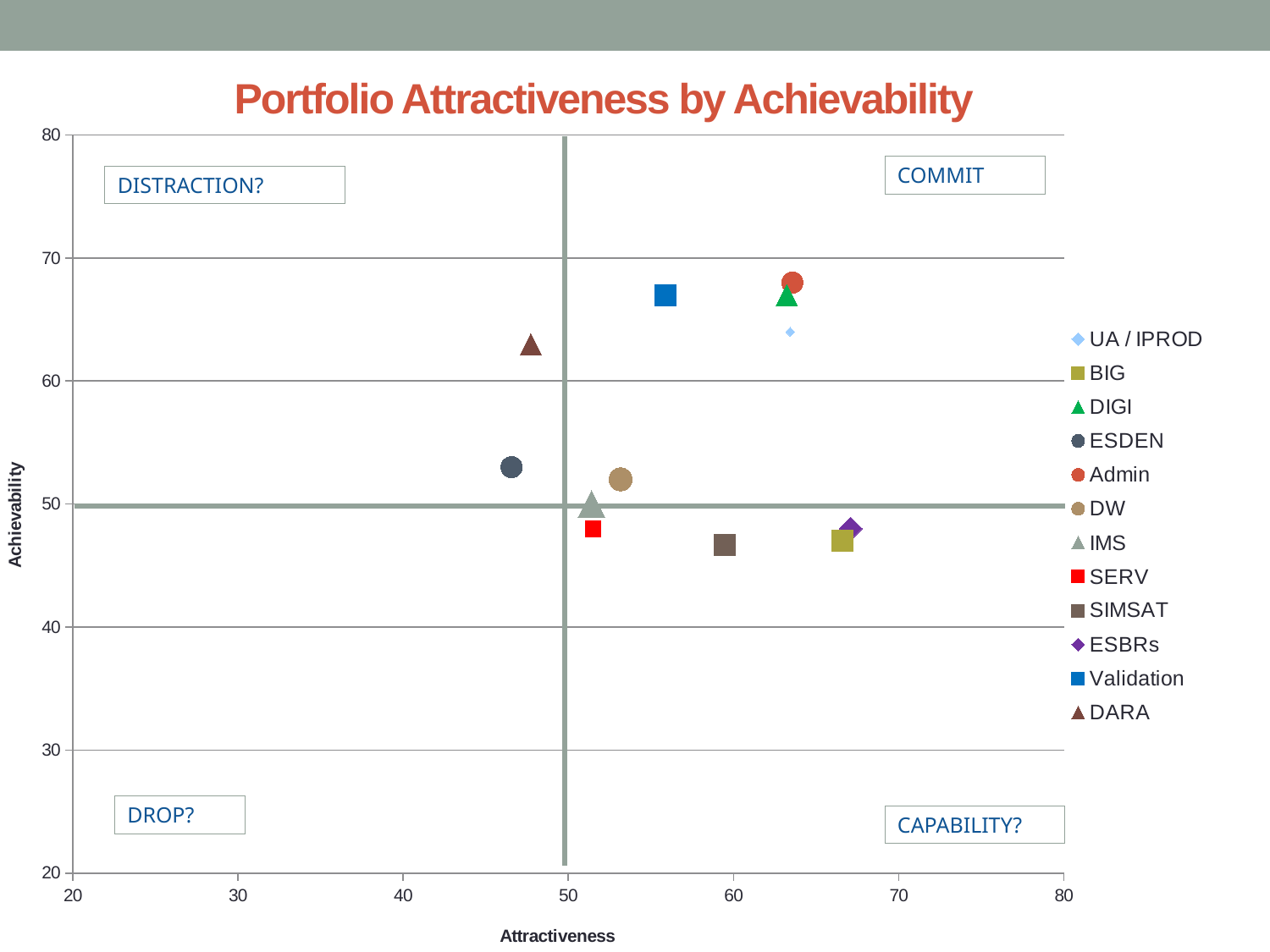
Which has the higher Attractiveness value, Admin or DW? Admin Is the Attractiveness value for BIG greater or less than 60? greater Is the Achievability value for ESDEN greater or less than 50? greater Which has the higher Achievability value, Validation or SIMSAT? Validation What is the title of the chart? Portfolio Attractiveness by Achievability Is the Achievability value for SIMSAT greater or less than 50? less How many series does the legend list? 12 What kind of chart is shown on the slide? scatter chart Which quadrant label appears in the top-right area of the chart? COMMIT